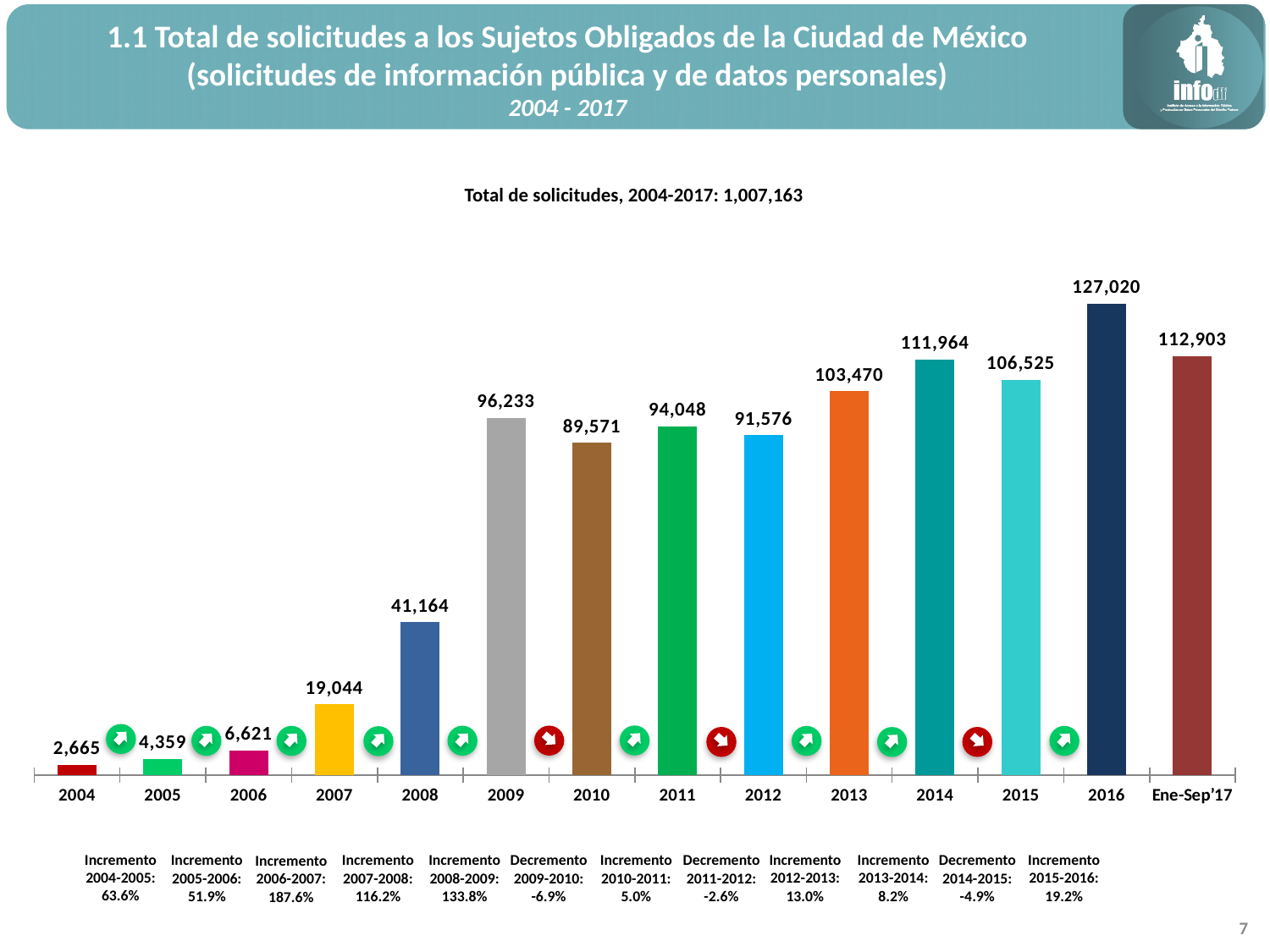
What is the value for 2004? 2,665 What kind of chart is shown on the slide? Bar chart What is the difference between the values for 2009 and 2010? 6,662 How many categories are shown on the x axis? 14 Which year has the highest value? 2016 Which is larger, the value for 2011 or the value for 2012? 2011 What total of solicitudes for 2004-2017 is stated above the chart? 1,007,163 What is the value for 2016? 127,020 What is the value for Ene-Sep'17? 112,903 Which year has the lowest value? 2004 What is the value for 2009? 96,233 What is the difference between the values for 2016 and 2015? 20,495